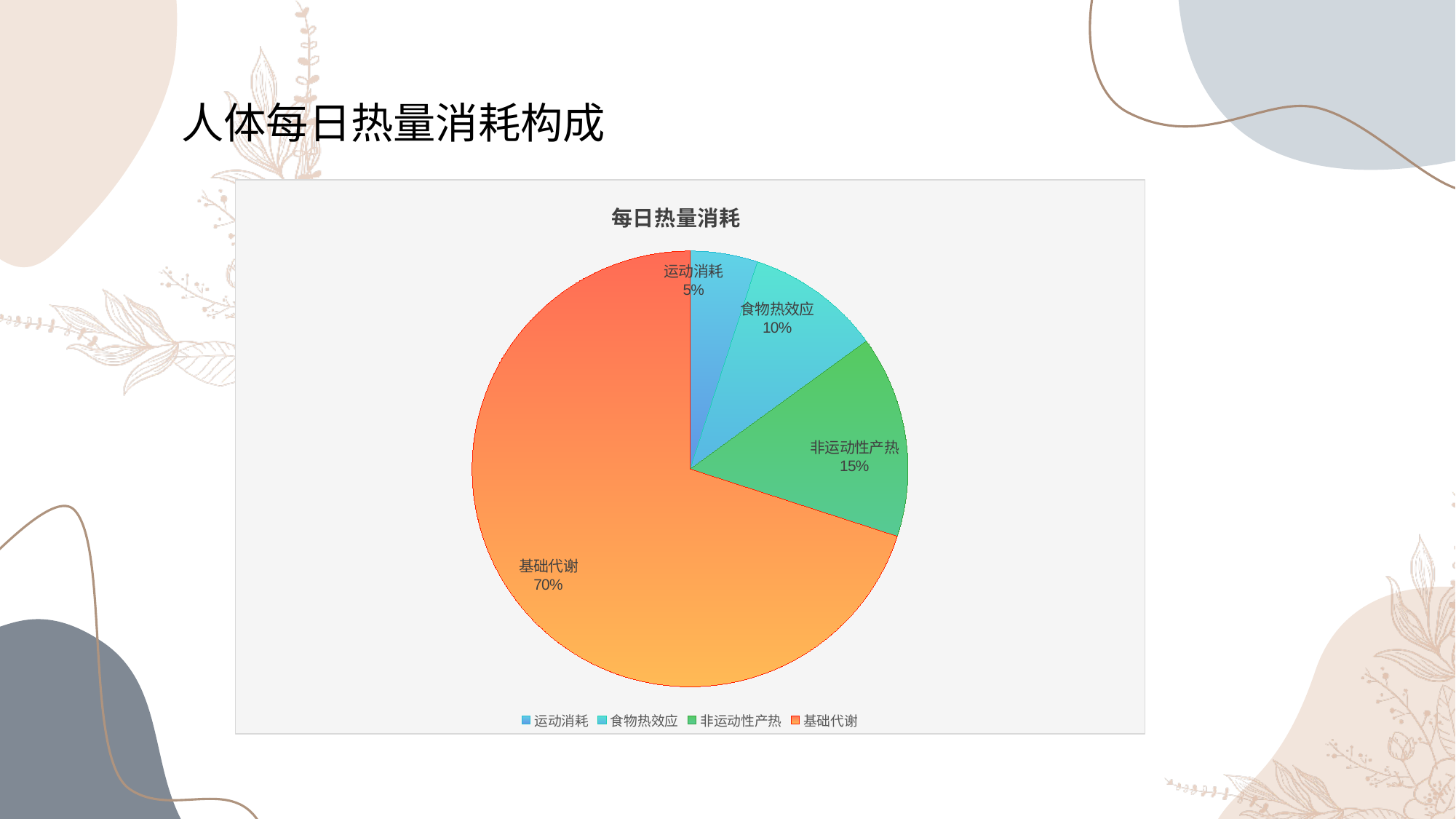
Which category has the smallest slice of the pie? 运动消耗 Which is larger, the share of 食物热效应 or the share of 运动消耗? 食物热效应 What kind of chart is shown on the slide? pie chart What is the title of the chart? 每日热量消耗 Which category is shown in green in the pie chart? 非运动性产热 What is the value shown for 运动消耗? 5% What is the difference between the shares of 基础代谢 and 非运动性产热? 55% What is the value shown for 食物热效应? 10% How many slices does the pie chart have? 4 What share of the pie does 基础代谢 take? 70% Which category has the largest slice of the pie? 基础代谢 What is the value shown for 非运动性产热? 15%